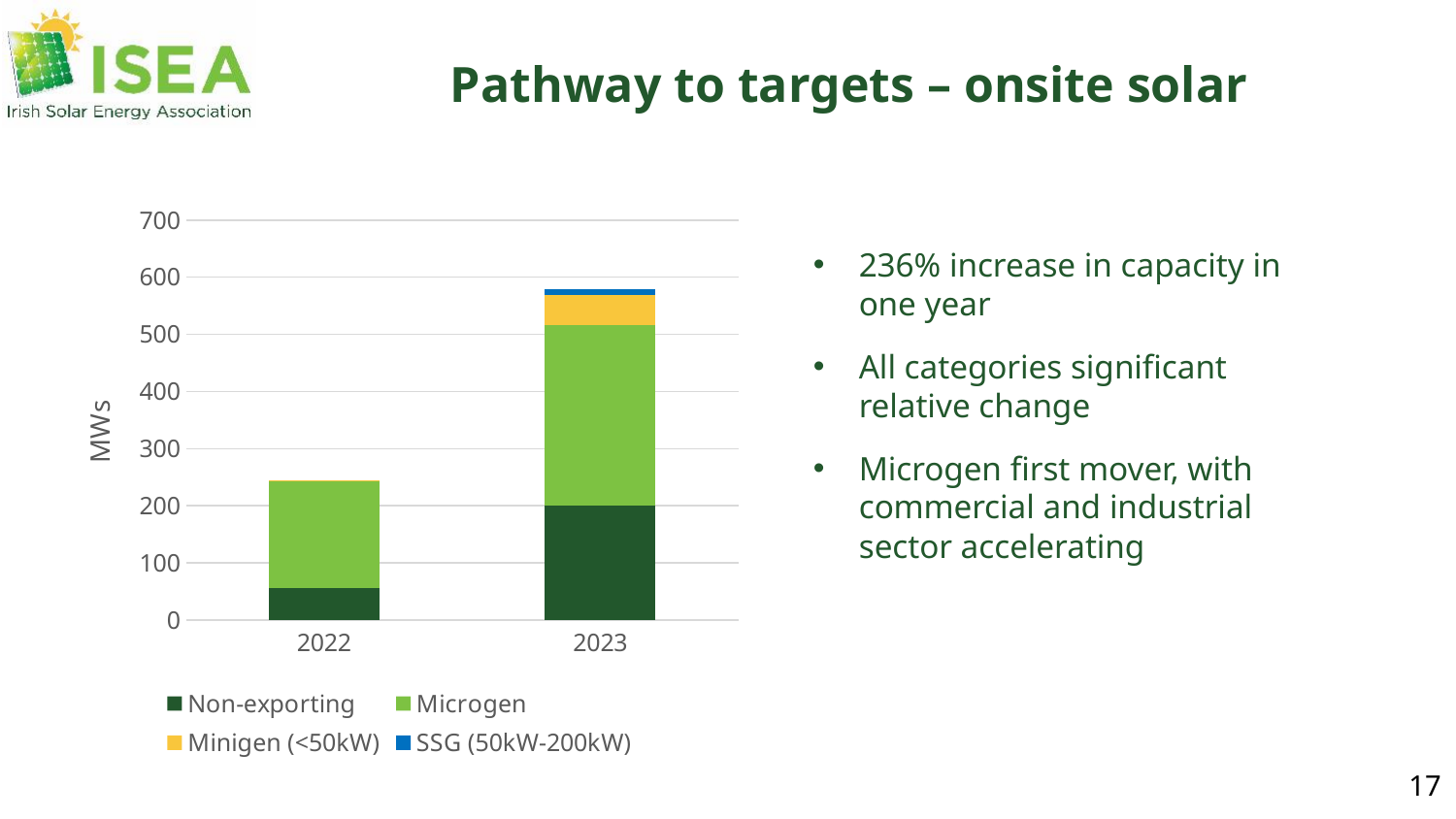
What is the label on the chart's vertical axis? MWs Is the total stacked value for 2023 greater or less than 500? greater Do the total stacked values rise or fall from 2022 to 2023? rise How many series does the chart's legend list? 4 Which year has the larger Non-exporting segment, 2022 or 2023? 2023 Is the Non-exporting segment for 2022 greater or less than 100? less What kind of chart is shown on the slide? Stacked bar chart Is the total stacked value for 2022 greater or less than 300? less Which year has the shorter stacked bar? 2022 How many years are shown on the x axis of the chart? 2 Which year has the taller stacked bar? 2023 Which series is shown in yellow in the chart's legend? Minigen (<50kW)